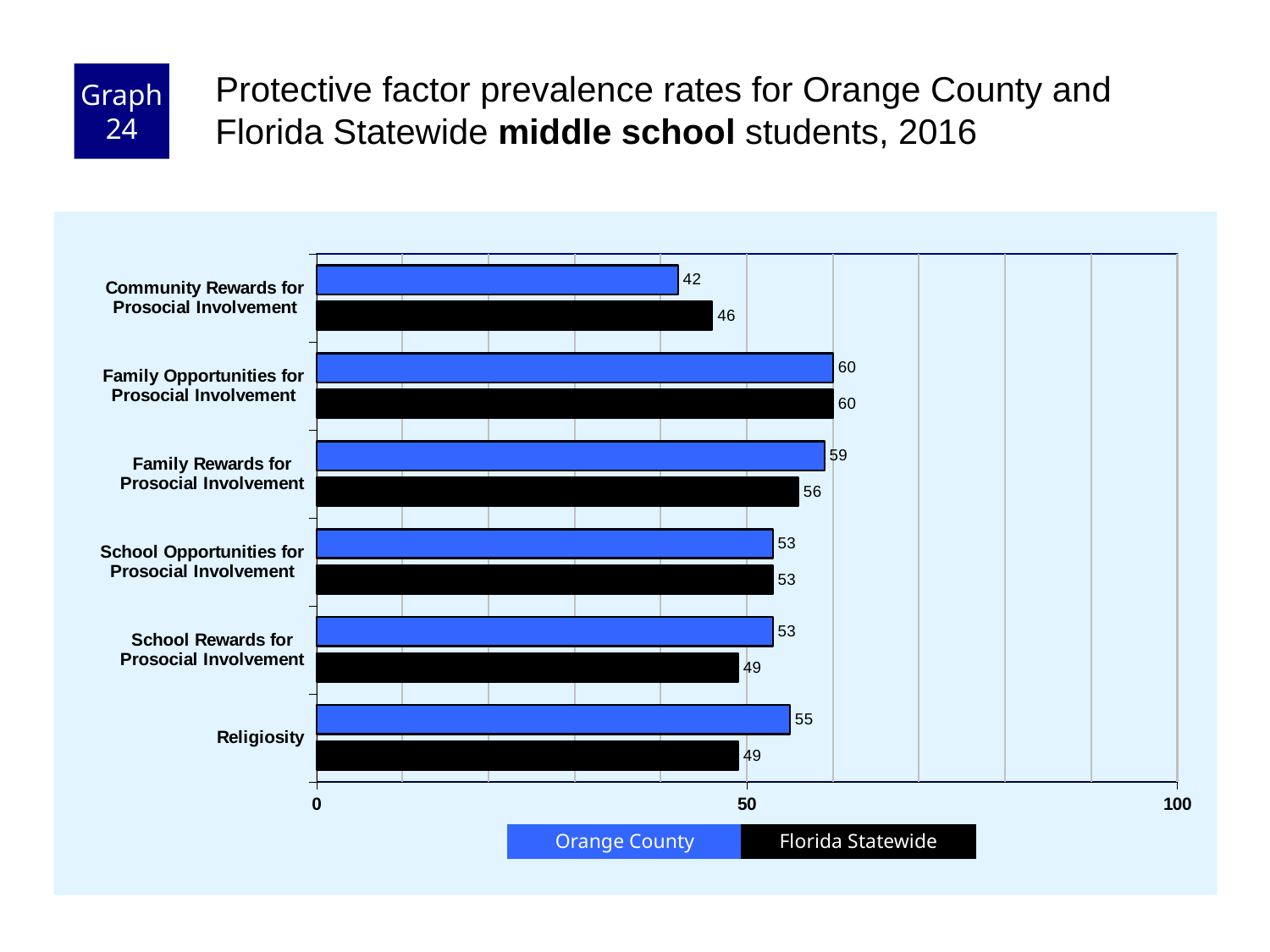
What kind of chart is shown on the slide? Bar chart Which category has the highest Orange County value? Family Opportunities for Prosocial Involvement Which category has the lowest Florida Statewide value? Community Rewards for Prosocial Involvement What is the Orange County value for Community Rewards for Prosocial Involvement? 42 What is the Florida Statewide value for Family Rewards for Prosocial Involvement? 56 What is the difference between the Orange County and Florida Statewide values for Religiosity? 6 How many categories are shown on the chart? 6 For School Rewards for Prosocial Involvement, which is larger: the Orange County value or the Florida Statewide value? Orange County What is the difference between the Florida Statewide values for Family Opportunities for Prosocial Involvement and Community Rewards for Prosocial Involvement? 14 How many series does the legend list? 2 Is the Orange County value for Community Rewards for Prosocial Involvement greater or less than 50? less What is the Florida Statewide value for Religiosity? 49